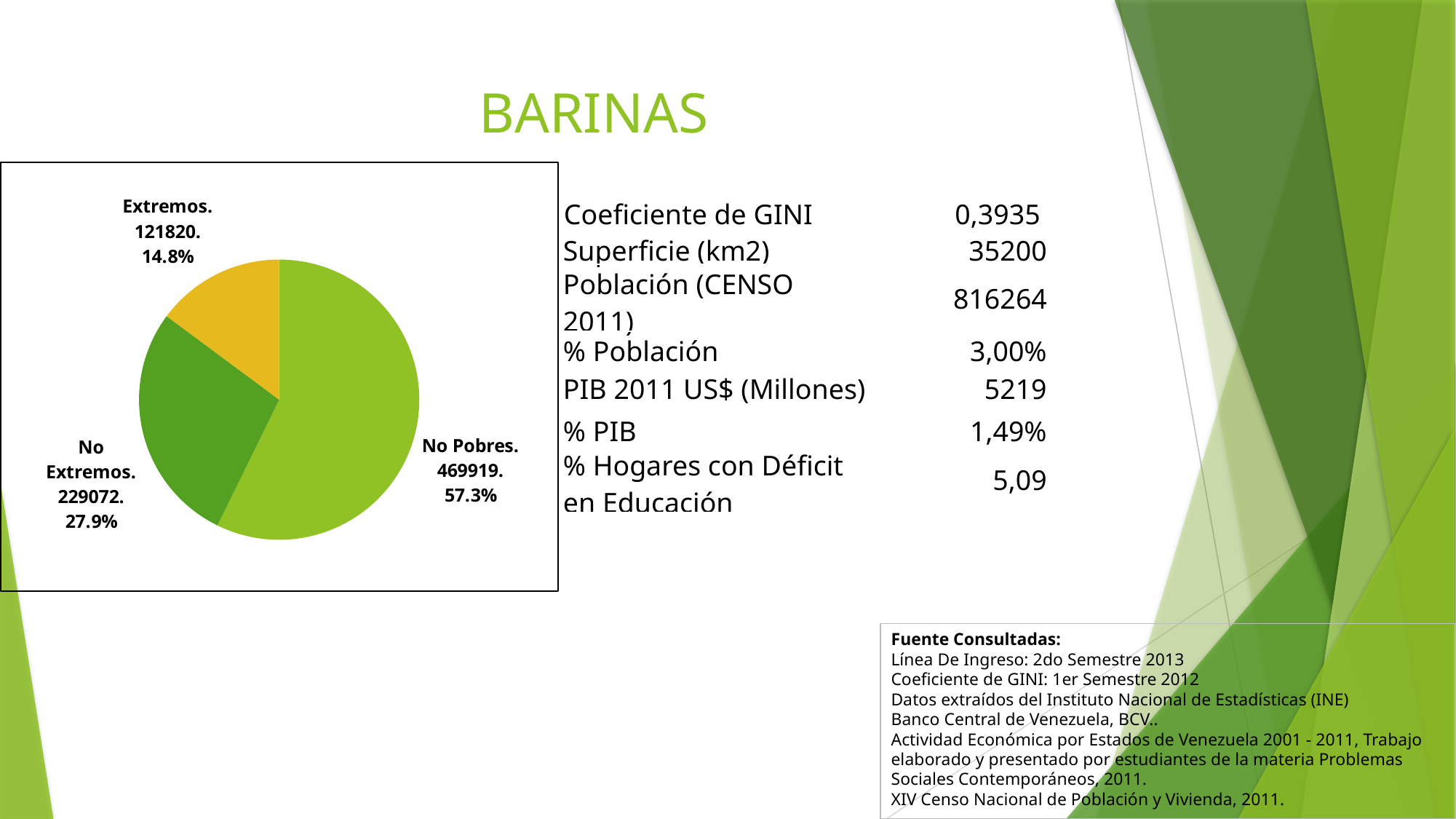
What share of the pie does the Extremos slice represent? 14.8% What colour is the Extremos slice in the pie chart? yellow Which slice of the pie chart is the smallest? Extremos What kind of chart is shown on the slide? pie chart What is the difference between the No Pobres value and the No Extremos value? 240847 How many slices does the pie chart have? 3 What is the value for No Extremos in the pie chart? 229072 Which is larger, the No Extremos slice or the Extremos slice? No Extremos What share of the pie does the No Pobres slice represent? 57.3% Which slice of the pie chart is the largest? No Pobres What is the value for No Pobres in the pie chart? 469919 What is the value for Extremos in the pie chart? 121820